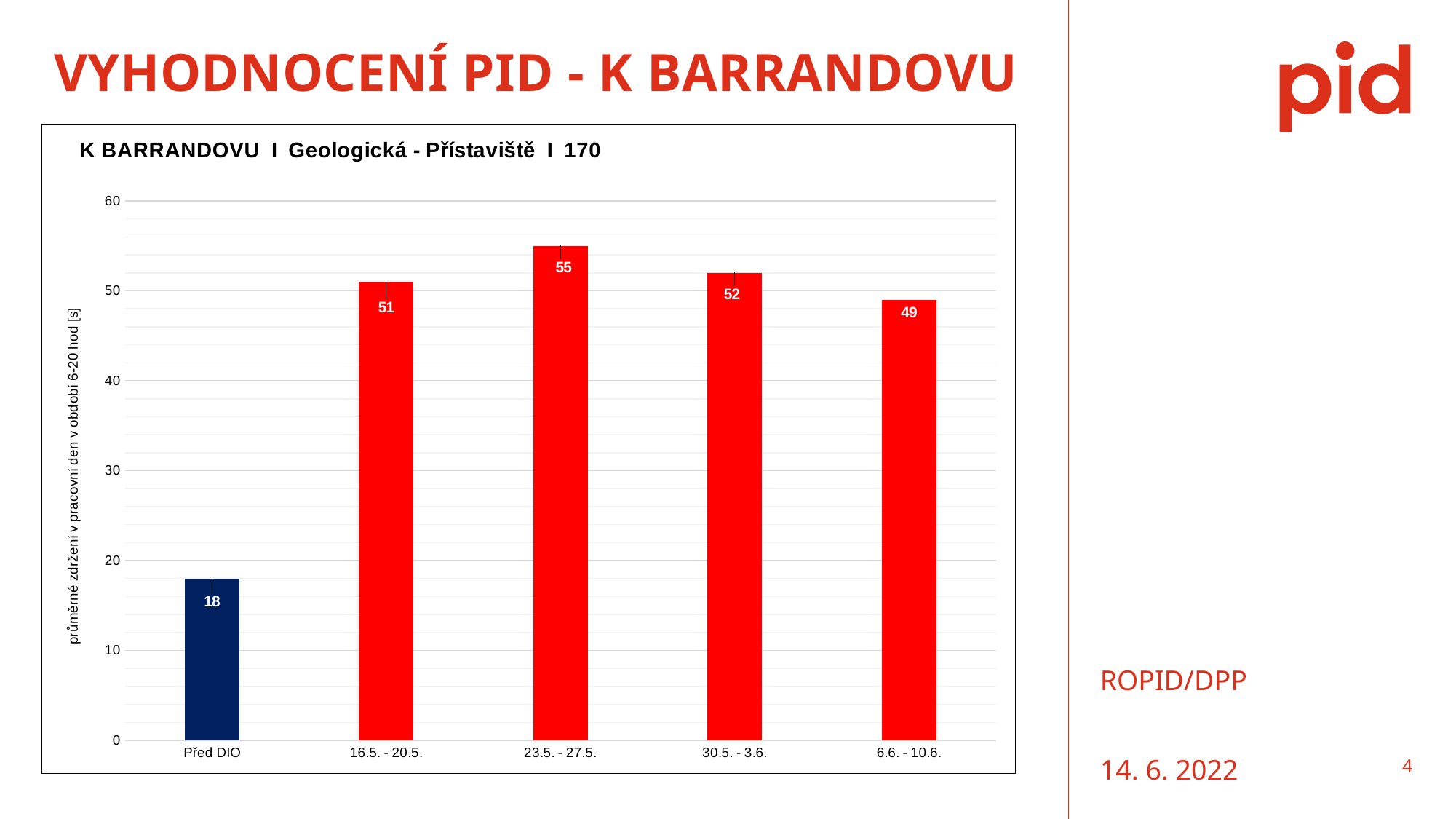
Which is larger, the value for "16.5. - 20.5." or the value for "23.5. - 27.5."? 23.5. - 27.5. How many categories are shown on the x axis? 5 What is the title of the chart? K BARRANDOVU I Geologická - Přístaviště I 170 Which category has the lowest value? Před DIO What kind of chart is shown on the slide? bar chart What is the value for "23.5. - 27.5."? 55 What is the value for "6.6. - 10.6."? 49 Which category has the highest value? 23.5. - 27.5. What is the difference between the values for "23.5. - 27.5." and "Před DIO"? 37 Is the value for "Před DIO" greater or less than 20? less What is the difference between the values for "30.5. - 3.6." and "6.6. - 10.6."? 3 What is the value for "Před DIO"? 18